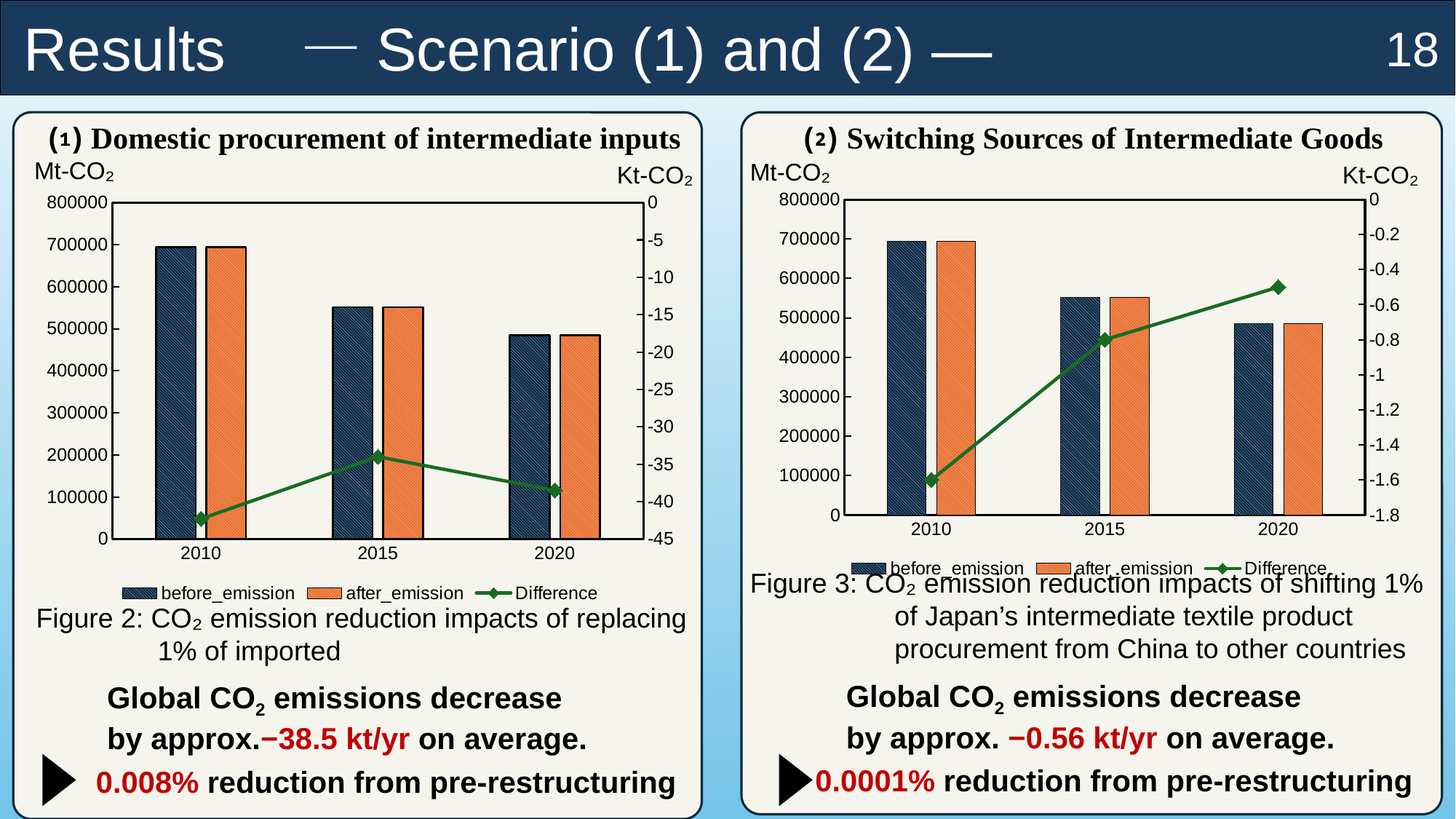
In the left chart '(1) Domestic procurement of intermediate inputs', which year has the highest before_emission bar? 2010 In the right chart '(2) Switching Sources of Intermediate Goods', what unit is shown on the right-hand axis? Kt-CO2 In the left chart '(1) Domestic procurement of intermediate inputs', is the before_emission value for 2010 greater or less than 600000? greater In the left chart '(1) Domestic procurement of intermediate inputs', how many series does the legend list? 3 In the right chart '(2) Switching Sources of Intermediate Goods', does the Difference line rise or fall from 2010 to 2020? rise In the left chart '(1) Domestic procurement of intermediate inputs', do the before_emission bars rise or fall from 2010 to 2020? fall In the right chart '(2) Switching Sources of Intermediate Goods', which is larger, the before_emission bar for 2010 or for 2015? 2010 In the left chart '(1) Domestic procurement of intermediate inputs', how many years are shown on the x axis? 3 In the left chart '(1) Domestic procurement of intermediate inputs', is the Difference value for 2010 greater or less than -40? less In the right chart '(2) Switching Sources of Intermediate Goods', is the Difference value for 2020 greater or less than -0.6? greater What kind of chart is shown in the left panel, '(1) Domestic procurement of intermediate inputs'? A combined bar and line chart In the left chart '(1) Domestic procurement of intermediate inputs', which year has the lowest after_emission bar? 2020